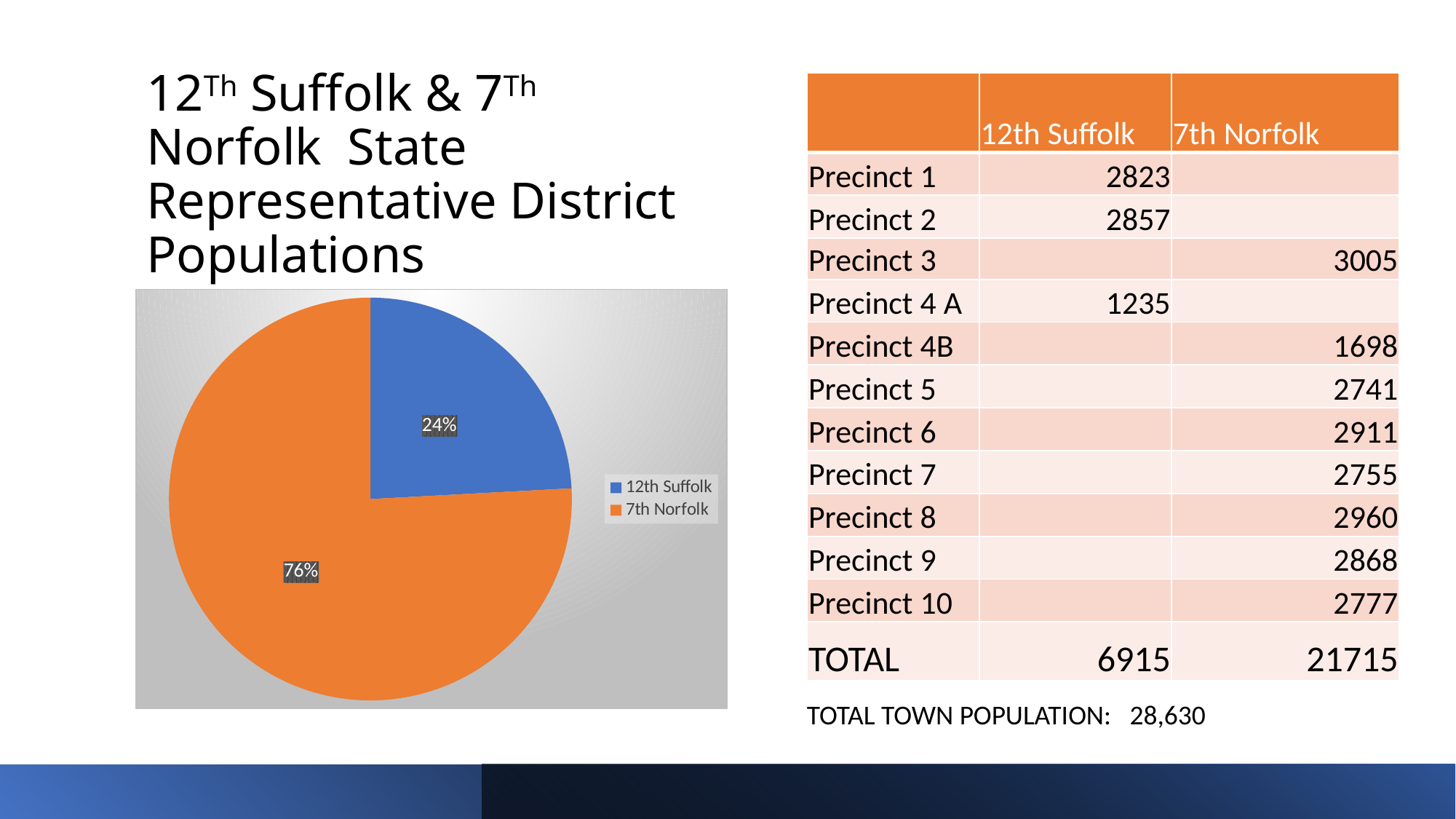
What is the difference in percentage points between the 7th Norfolk slice and the 12th Suffolk slice? 52 What share of the pie does 12th Suffolk represent? 24% What share of the pie does 7th Norfolk represent? 76% What colour is the 12th Suffolk slice in the pie chart? blue Which district has the smaller slice of the pie? 12th Suffolk How many slices does the pie chart have? 2 Is the 12th Suffolk slice larger or smaller than the 7th Norfolk slice? smaller How many entries does the legend list? 2 Which district has the larger slice of the pie? 7th Norfolk What colour is the 7th Norfolk slice in the pie chart? orange What kind of chart is shown on the slide? pie chart